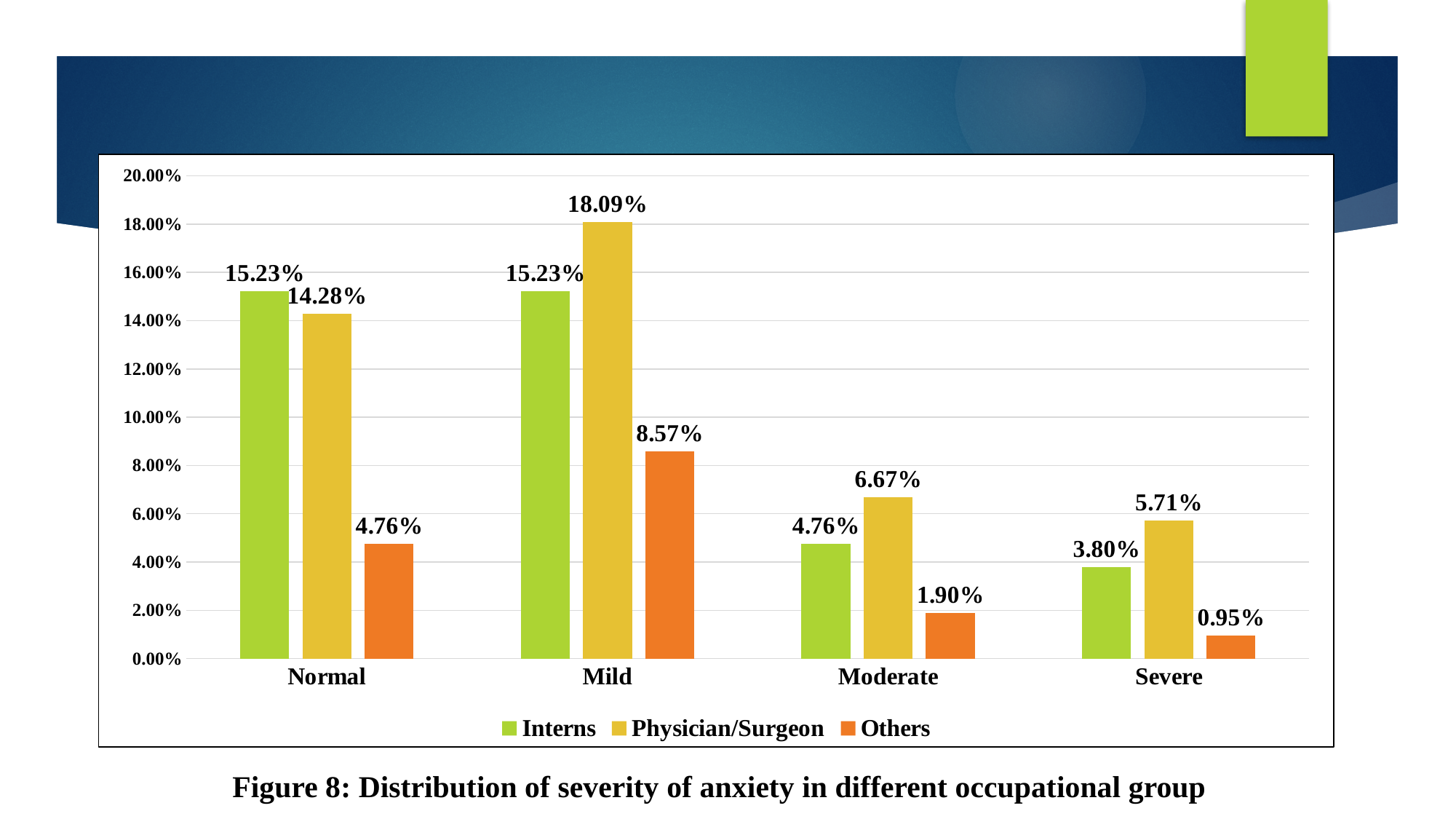
How many series does the legend list? 3 Which category has the highest Physician/Surgeon value? Mild Which is larger in the Normal category: Interns or Physician/Surgeon? Interns How many categories are shown on the x axis? 4 What is the difference between the Physician/Surgeon and Interns values in the Mild category? 2.86% What is the value for Interns in the Moderate category? 4.76% What is the value for Physician/Surgeon in the Mild category? 18.09% Is the value for Others in the Mild category greater or less than 8.00%? greater Which category has the lowest Others value? Severe What is the value for Others in the Severe category? 0.95% What kind of chart is shown on the slide? Bar chart What is the caption of the figure below the chart? Figure 8: Distribution of severity of anxiety in different occupational group